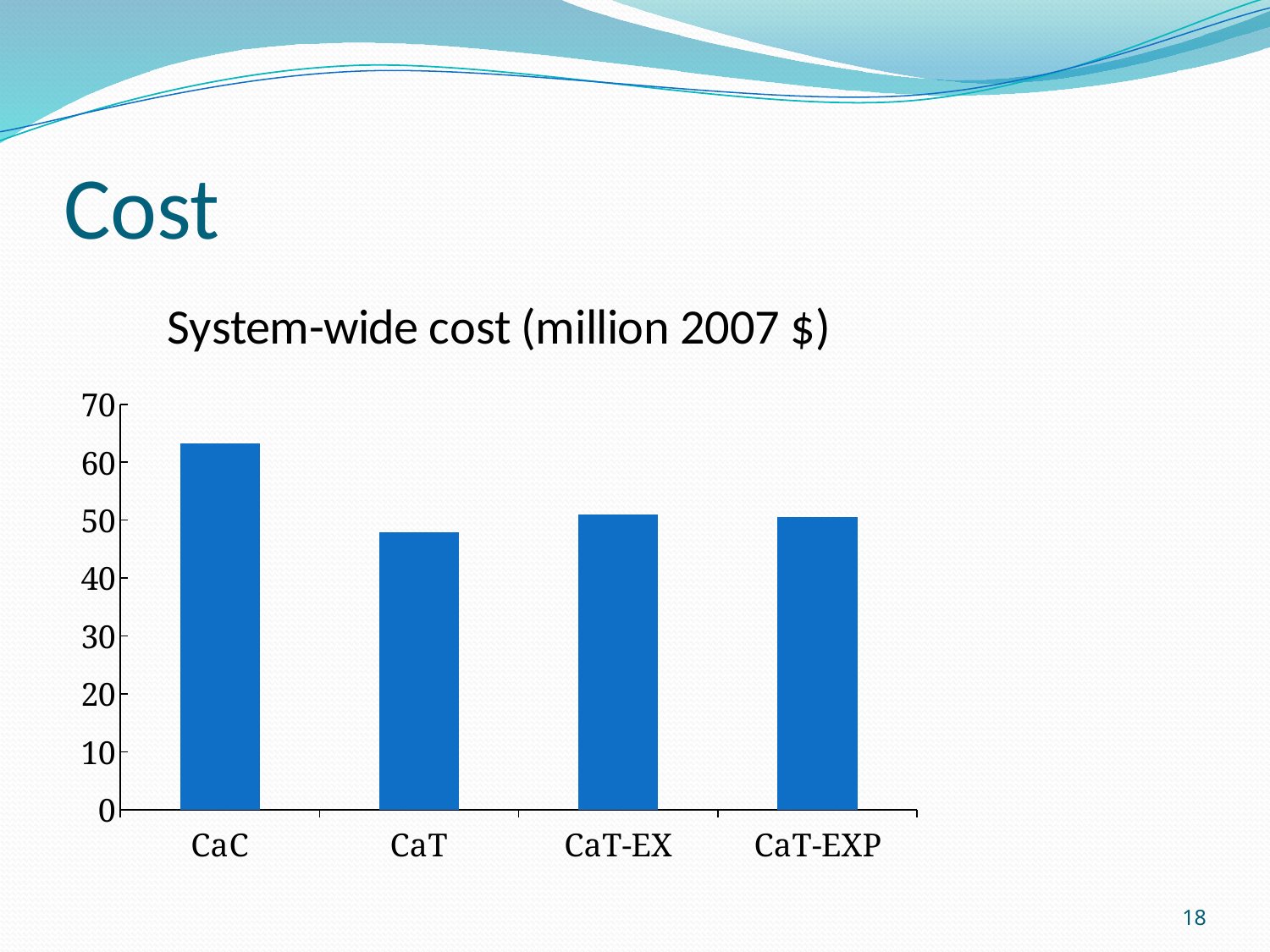
How many categories are plotted on the x axis? 4 Is the value for CaC greater or less than 70? less Is the value for CaT-EX greater or less than 40? greater Which is larger, the value for CaT or the value for CaT-EX? CaT-EX Which category has the highest system-wide cost? CaC What is the label of the last category on the x axis? CaT-EXP What kind of chart is shown on the slide? bar chart Which category has the lowest system-wide cost? CaT Is the value for CaT greater or less than 50? less Which is larger, the value for CaC or the value for CaT? CaC What is the title of the chart? System-wide cost (million 2007 $)